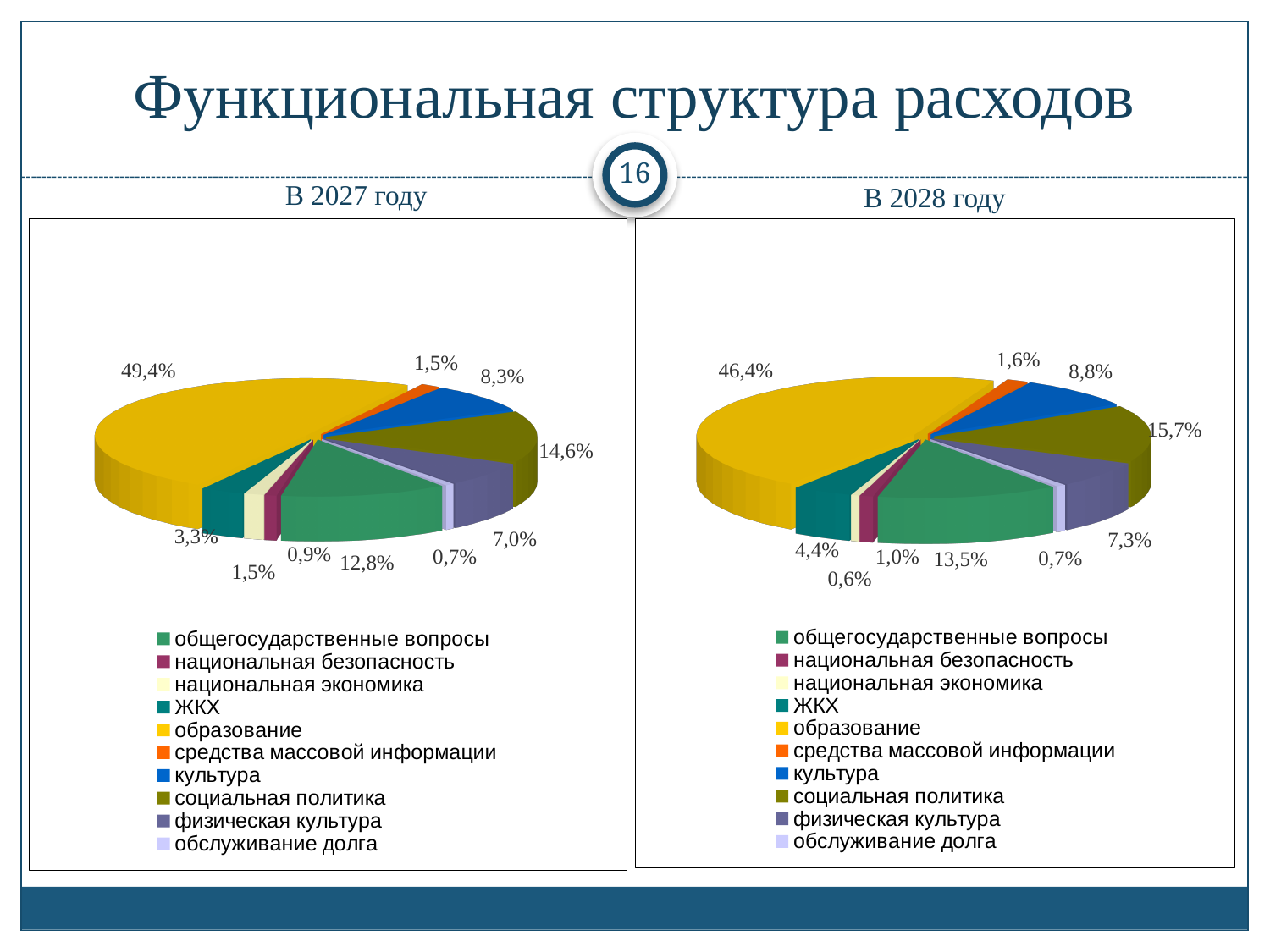
In the chart 'В 2028 году', what is the value for ЖКХ? 4,4% In the chart 'В 2027 году', what share does образование have? 49,4% In the chart 'В 2027 году', which category has the smallest slice? обслуживание долга In the chart 'В 2028 году', what share does образование have? 46,4% In the chart 'В 2028 году', what is the difference between культура and физическая культура? 1,5% In the chart 'В 2027 году', what is the value for социальная политика? 14,6% In the chart 'В 2028 году', which category has the smallest slice? национальная экономика In the chart 'В 2028 году', what is the value for социальная политика? 15,7% How many categories does the legend of the chart 'В 2028 году' list? 10 What kind of chart is shown for 'В 2027 году'? pie chart In the chart 'В 2027 году', which category has the largest slice? образование In the chart 'В 2027 году', which is larger: общегосударственные вопросы or культура? общегосударственные вопросы